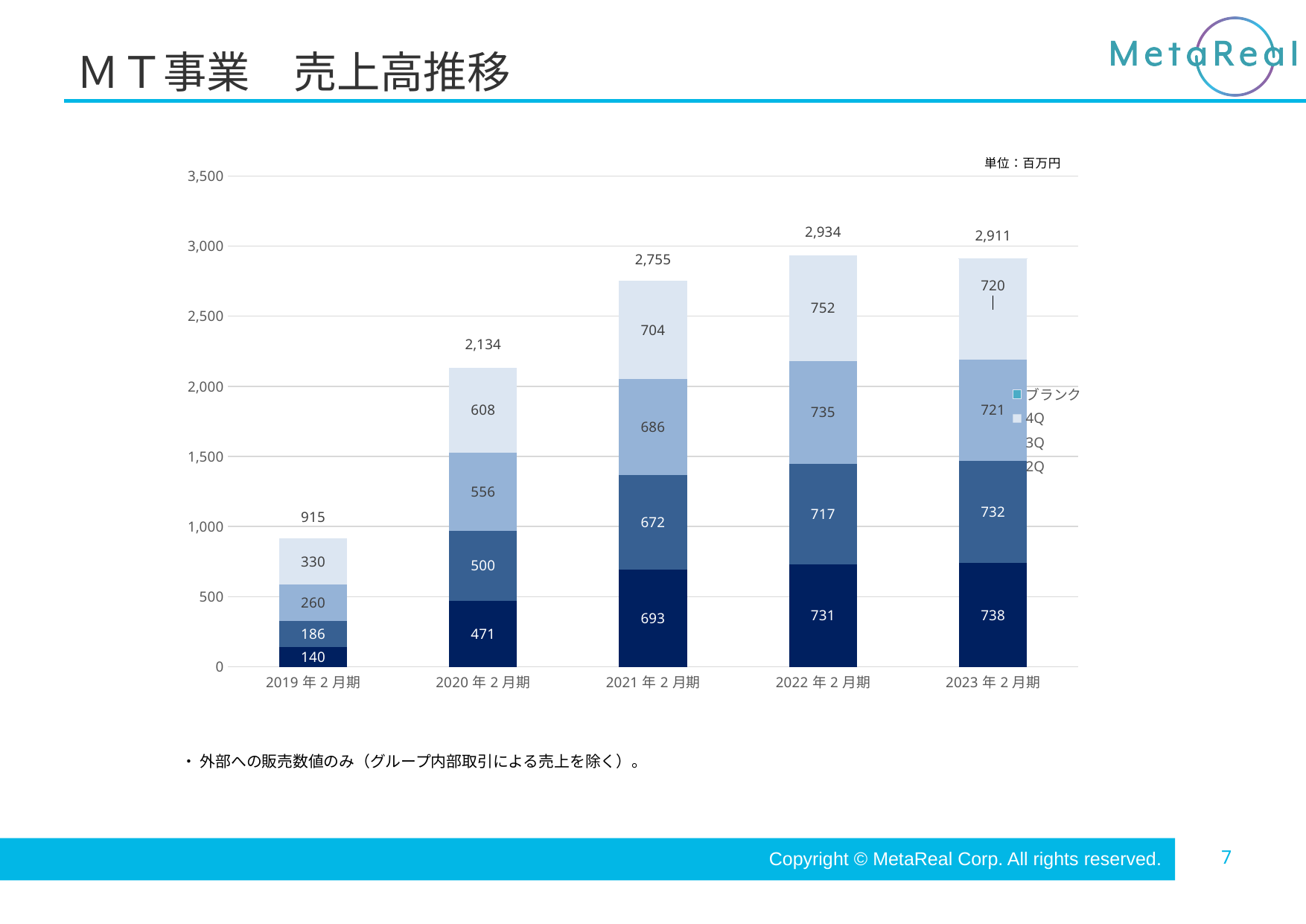
Do the total sales rise or fall from 2019年2月期 to 2022年2月期? rise Which fiscal period has the highest total sales? 2022年2月期 What kind of chart is shown on the slide? stacked bar chart What is the value of the 4Q segment (top segment) for 2021年2月期? 704 What is the total sales value shown above the bar for 2022年2月期? 2,934 Which has the larger total sales, 2020年2月期 or 2021年2月期? 2021年2月期 Which fiscal period has the lowest total sales? 2019年2月期 What unit is stated for the values in the chart? 百万円 How many fiscal periods are shown on the x axis? 5 What is the difference between the total sales for 2022年2月期 and 2023年2月期? 23 What is the value of the bottom segment of the bar for 2023年2月期? 738 Is the total sales for 2020年2月期 greater or less than 2,000? greater